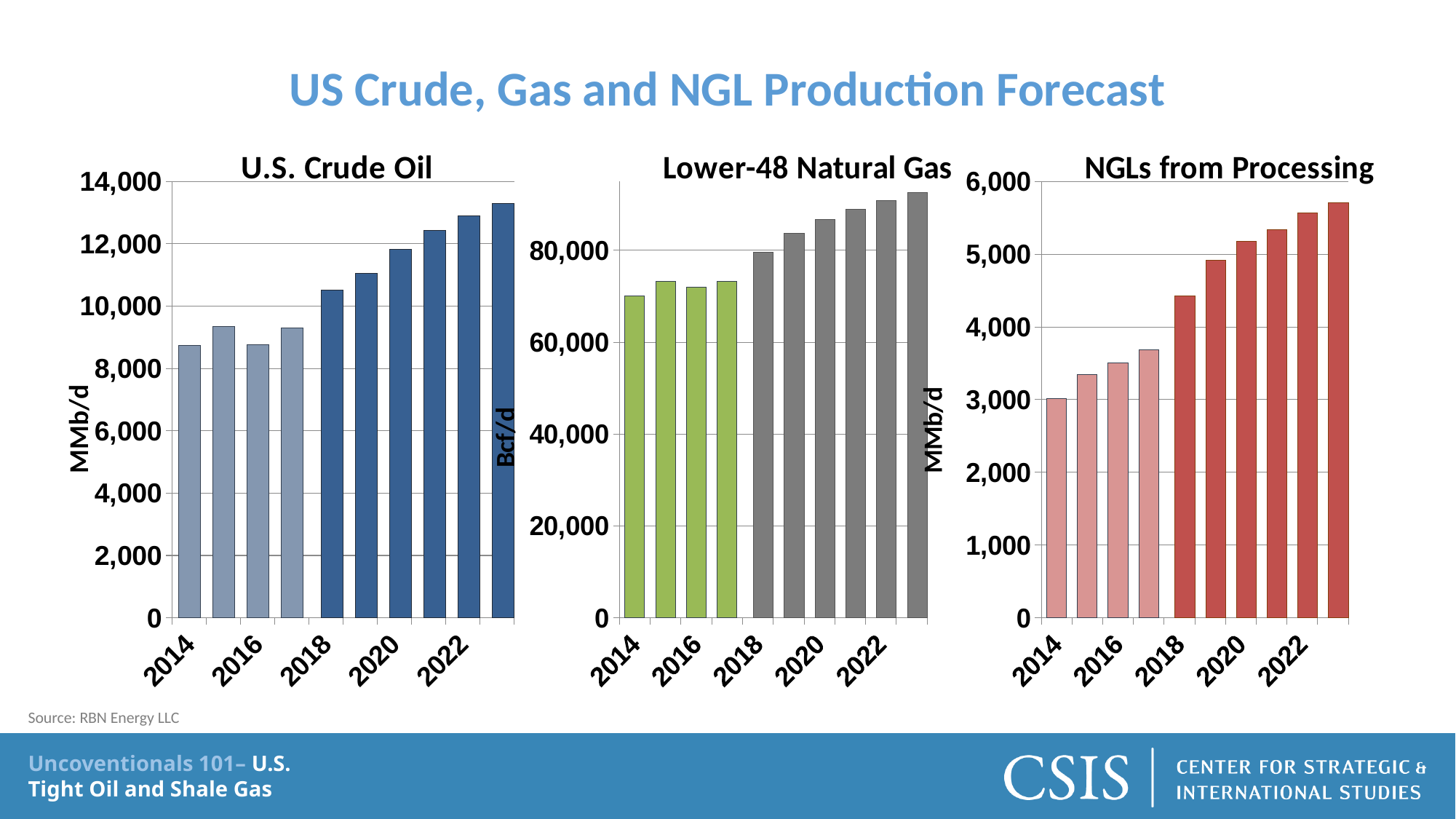
In the Lower-48 Natural Gas chart, which is larger, the value for 2018 or the value for 2016? 2018 In the NGLs from Processing chart, is the value for 2023 greater or less than 5,000? greater In the Lower-48 Natural Gas chart, which year has the highest value? 2023 In the NGLs from Processing chart, do the values generally rise or fall from 2014 to 2023? rise In the U.S. Crude Oil chart, how many bars (years) are plotted? 10 In the U.S. Crude Oil chart, is the value for 2014 greater or less than 10,000? less In the NGLs from Processing chart, which year has the lowest value? 2014 In the U.S. Crude Oil chart, which year has the highest value? 2023 In the U.S. Crude Oil chart, is the value for 2023 greater or less than 12,000? greater What kind of chart is the U.S. Crude Oil chart? bar chart What unit is shown on the y axis of the Lower-48 Natural Gas chart? Bcf/d